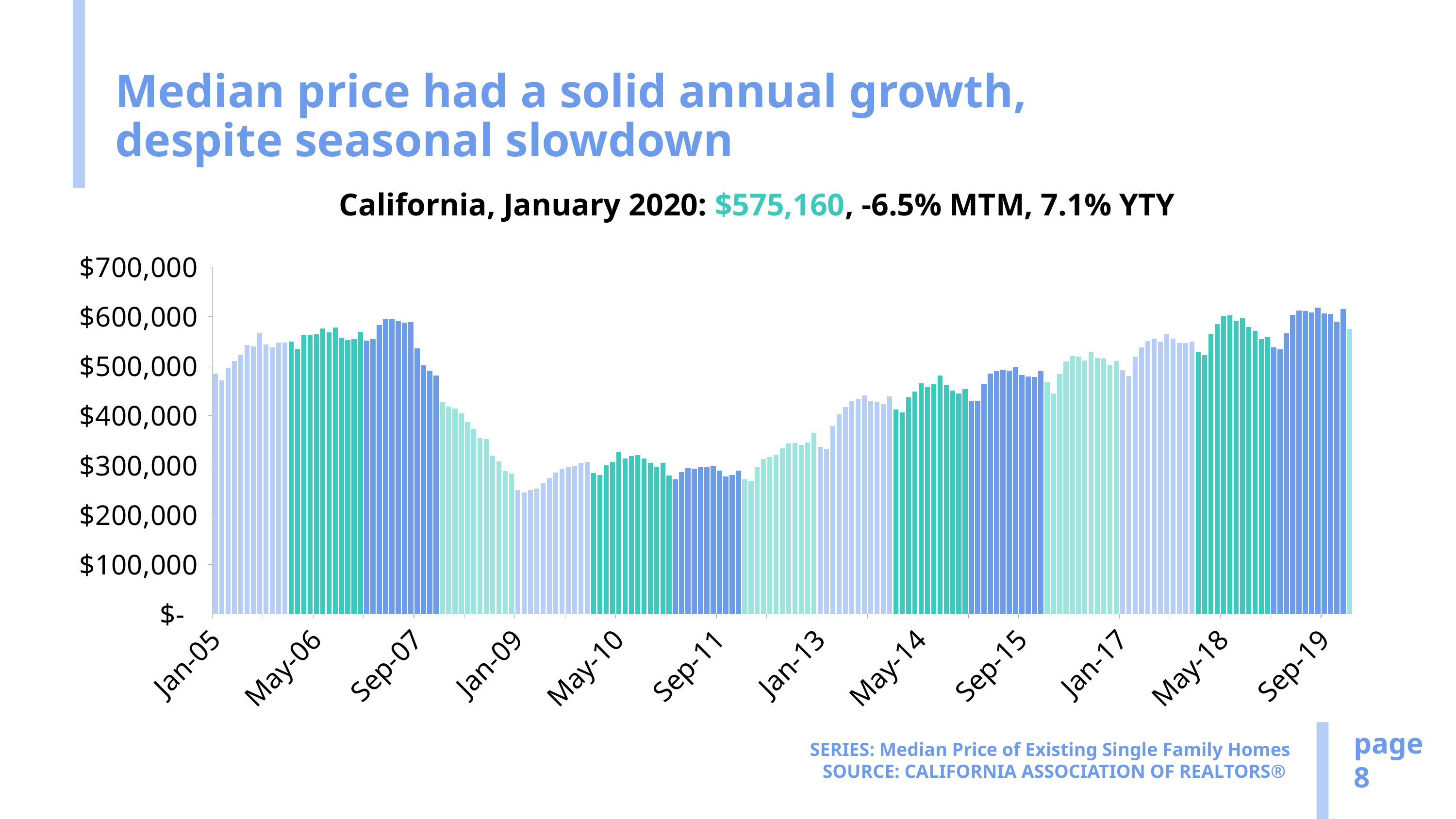
What year-to-year (YTY) change is stated for January 2020? 7.1% What is the California median price for January 2020 stated on the slide? $575,160 Which is larger, the value for Jan-13 or the value for May-14? May-14 Do the values rise or fall between Sep-07 and Jan-09? fall What kind of chart is shown on the slide? bar chart Is the value for Sep-07 greater or less than $500,000? greater Is the value for Jan-09 greater or less than $300,000? less Which is larger, the value for Sep-07 or the value for Jan-09? Sep-07 Is the value for Sep-19 greater or less than $500,000? greater Around which labelled date on the x axis are the values lowest? Jan-09 What month-to-month (MTM) change is stated for January 2020? -6.5%